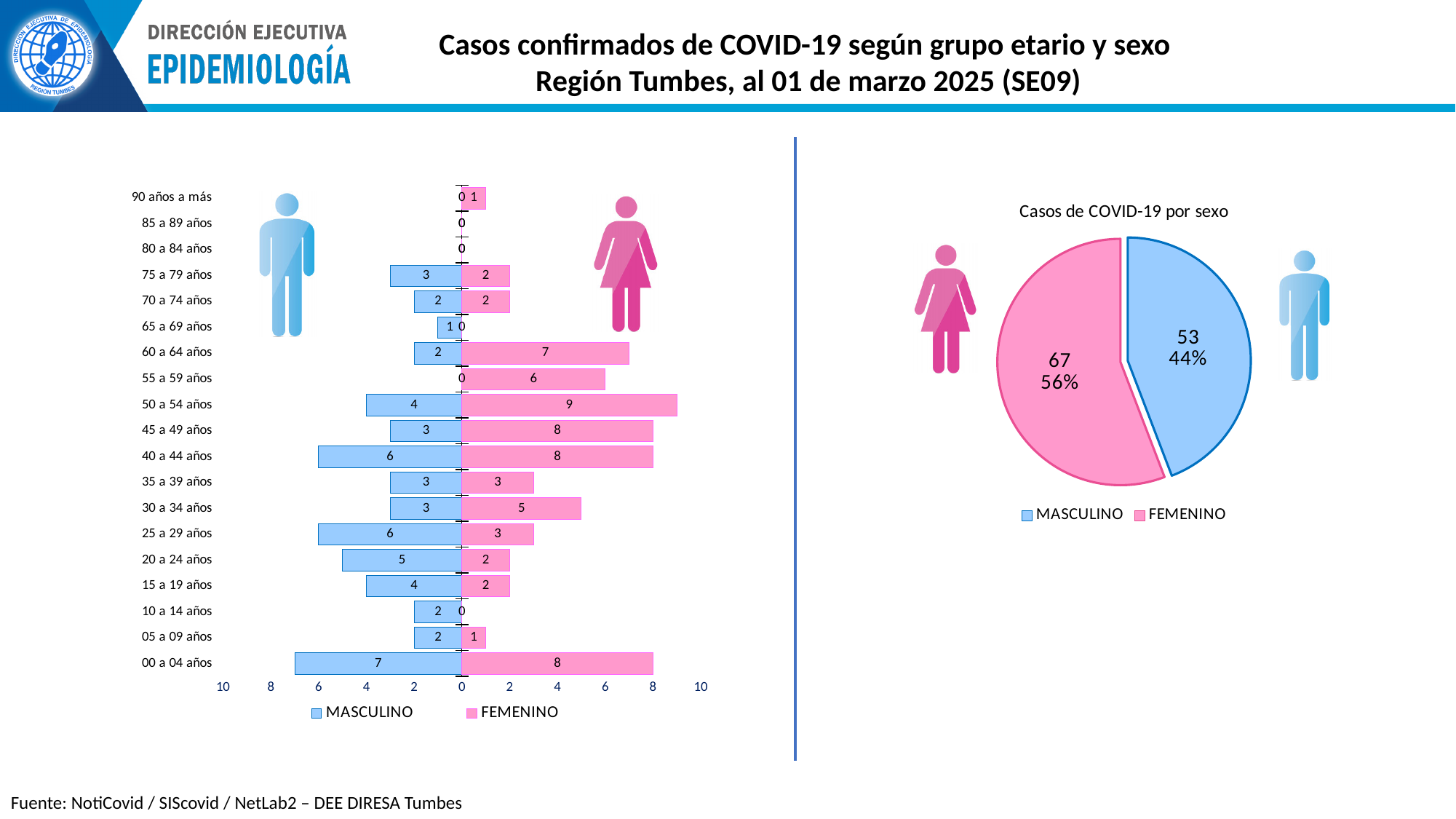
In the left chart, which age group has the highest number of MASCULINO cases? 00 a 04 años In the left chart, how many FEMENINO cases are there in the 60 a 64 años group? 7 In the left chart, how many MASCULINO cases are there in the 40 a 44 años group? 6 In the pie chart 'Casos de COVID-19 por sexo', what is the total number of cases across both slices? 120 How many series does the legend of the pie chart 'Casos de COVID-19 por sexo' list? 2 In the left chart, how many age groups are shown on the vertical axis? 19 In the left chart, which age group has the highest number of FEMENINO cases? 50 a 54 años What type of chart is the left chart? Bar chart In the left chart, which is larger in the 25 a 29 años group, MASCULINO or FEMENINO? MASCULINO In the pie chart 'Casos de COVID-19 por sexo', what share of cases is MASCULINO? 44% In the pie chart 'Casos de COVID-19 por sexo', how many cases are FEMENINO? 67 In the left chart, what is the difference between FEMENINO and MASCULINO cases in the 50 a 54 años group? 5